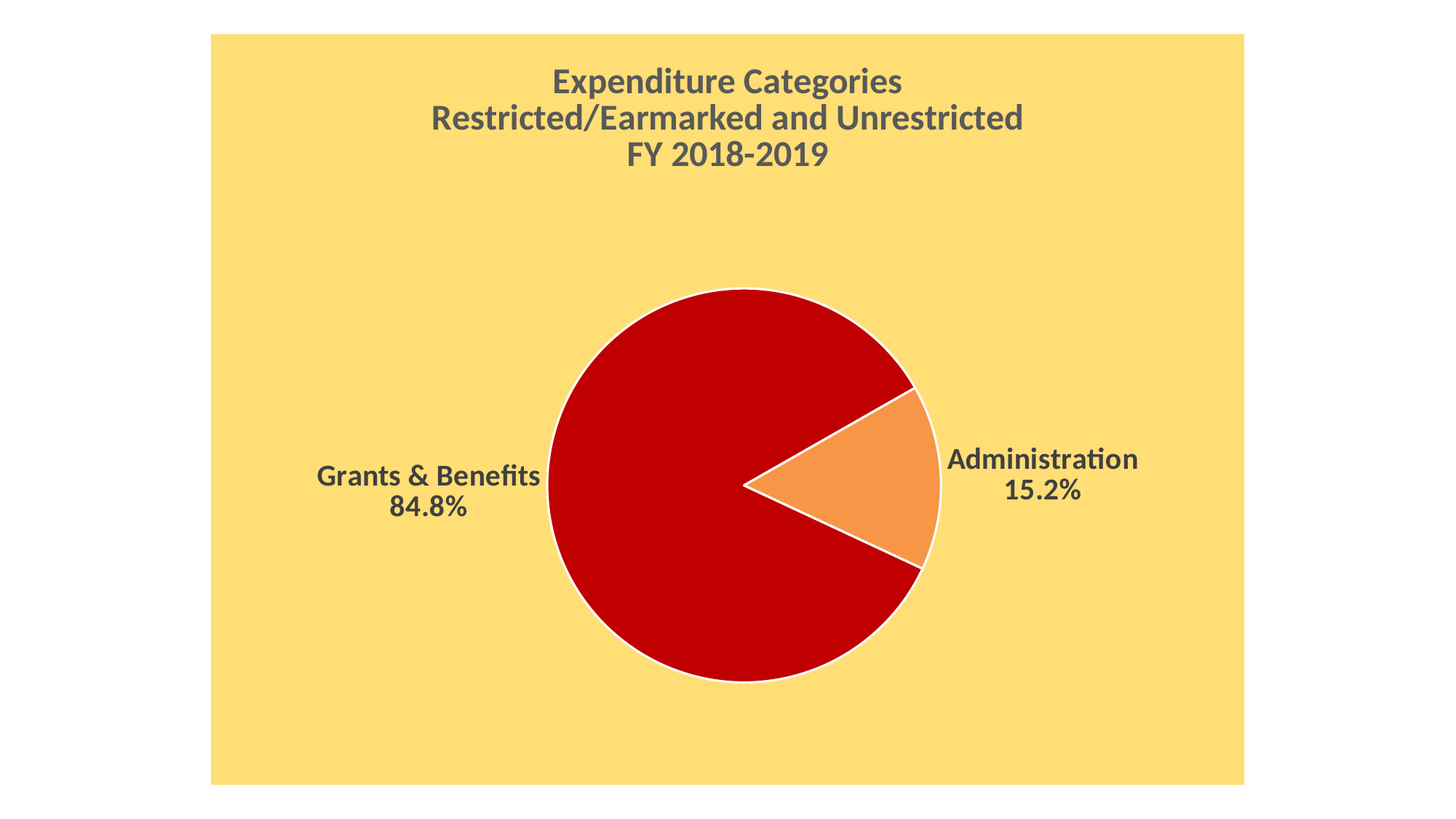
What is the title of the chart? Expenditure Categories Restricted/Earmarked and Unrestricted FY 2018-2019 What kind of chart is shown on the slide? pie chart Which fiscal year does the chart cover? FY 2018-2019 What is the difference in percentage points between Grants & Benefits and Administration? 69.6 What share of expenditure is Grants & Benefits? 84.8% What colour is the Administration slice? orange Which is larger, the share for Administration or the share for Grants & Benefits? Grants & Benefits How many slices does the pie chart have? 2 What share of expenditure is Administration? 15.2% Which category has the smallest share of the pie? Administration Which category has the largest share of the pie? Grants & Benefits